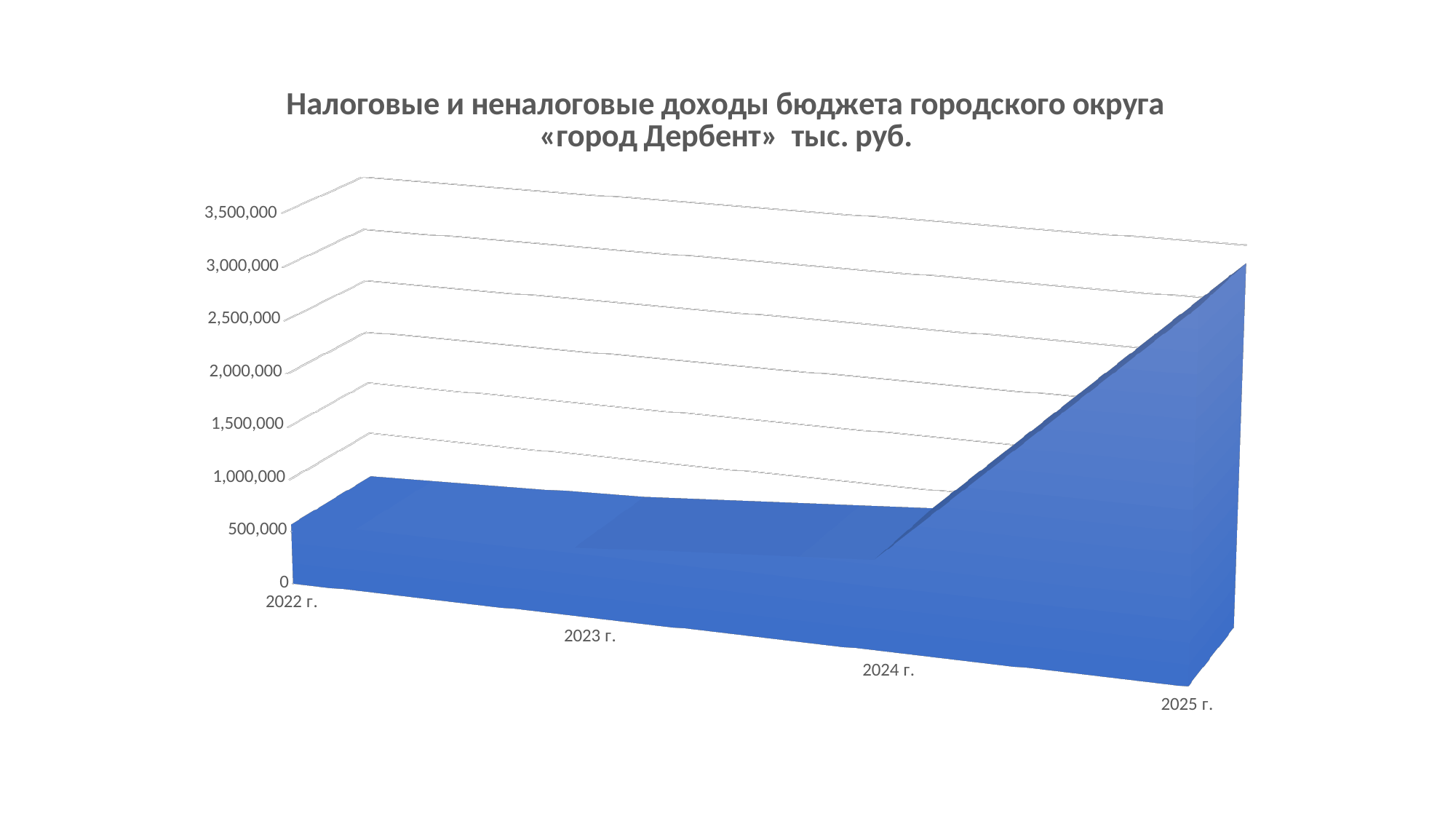
How many years are plotted on the x axis? 4 What is the highest value shown on the vertical axis? 3,500,000 Which year has the highest value? 2025 г. In what units are the values given according to the chart title? тыс. руб. Do the values rise or fall from 2024 г. to 2025 г.? rise Which is larger, the value for 2025 г. or the value for 2022 г.? 2025 г. Is the value for 2024 г. greater or less than 2,000,000? less Is the value for 2022 г. greater or less than 1,000,000? less What kind of chart is shown on the slide? area chart Which is larger, the value for 2024 г. or the value for 2025 г.? 2025 г. Is the value for 2023 г. greater or less than 1,500,000? less